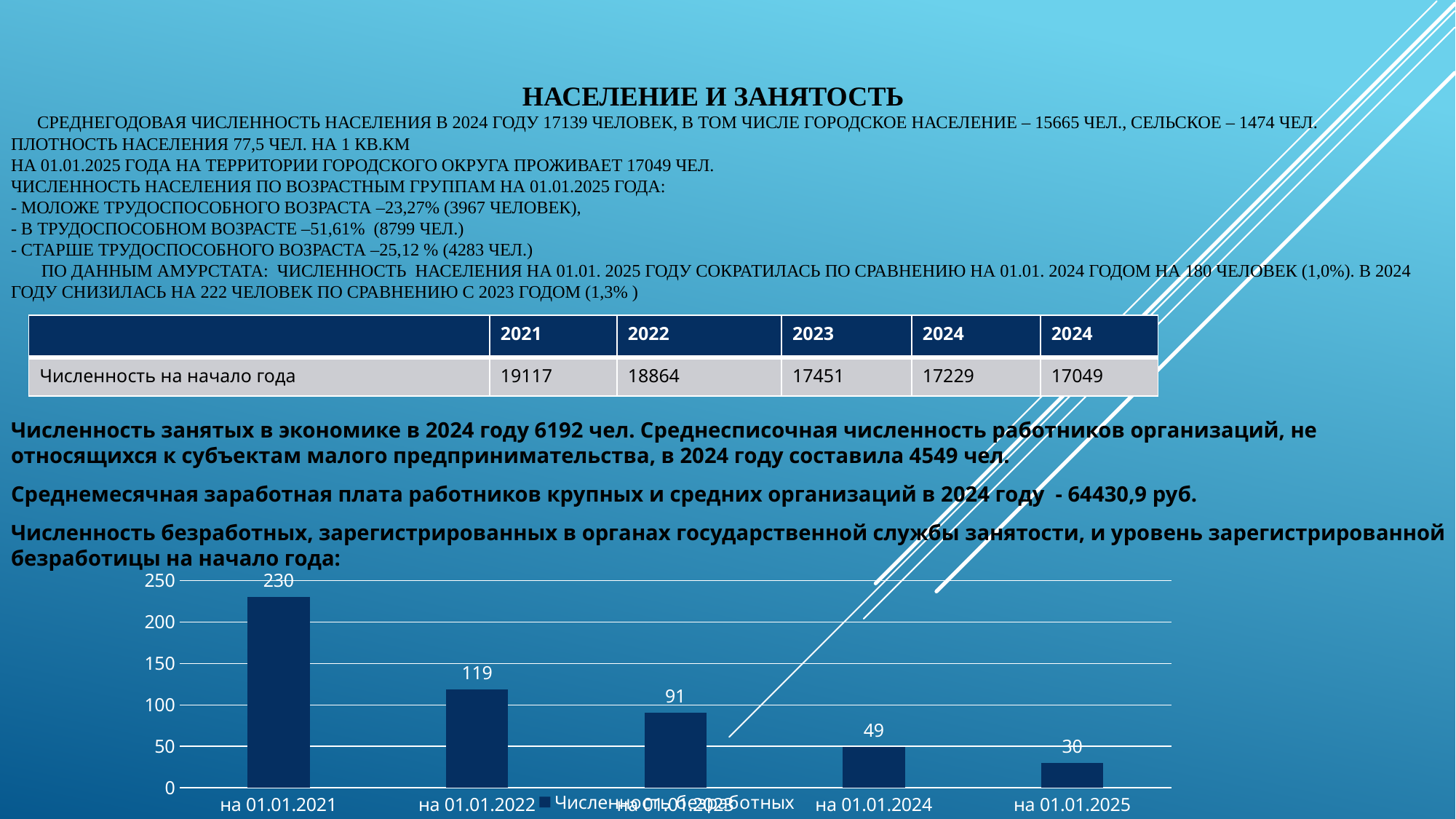
How many bars (categories) does the chart show? 5 What is the value for на 01.01.2025? 30 What is the value for на 01.01.2024? 49 Which category has the lowest value? на 01.01.2025 How many series does the chart legend list? 1 Which is larger, the value for на 01.01.2024 or the value for на 01.01.2025? на 01.01.2024 What is the value for на 01.01.2022? 119 Do the values rise or fall from left to right along the x axis? fall What is the value for на 01.01.2021? 230 What is the difference between the values for на 01.01.2021 and на 01.01.2022? 111 Which category has the highest value? на 01.01.2021 What type of chart is shown at the bottom of the slide? bar chart